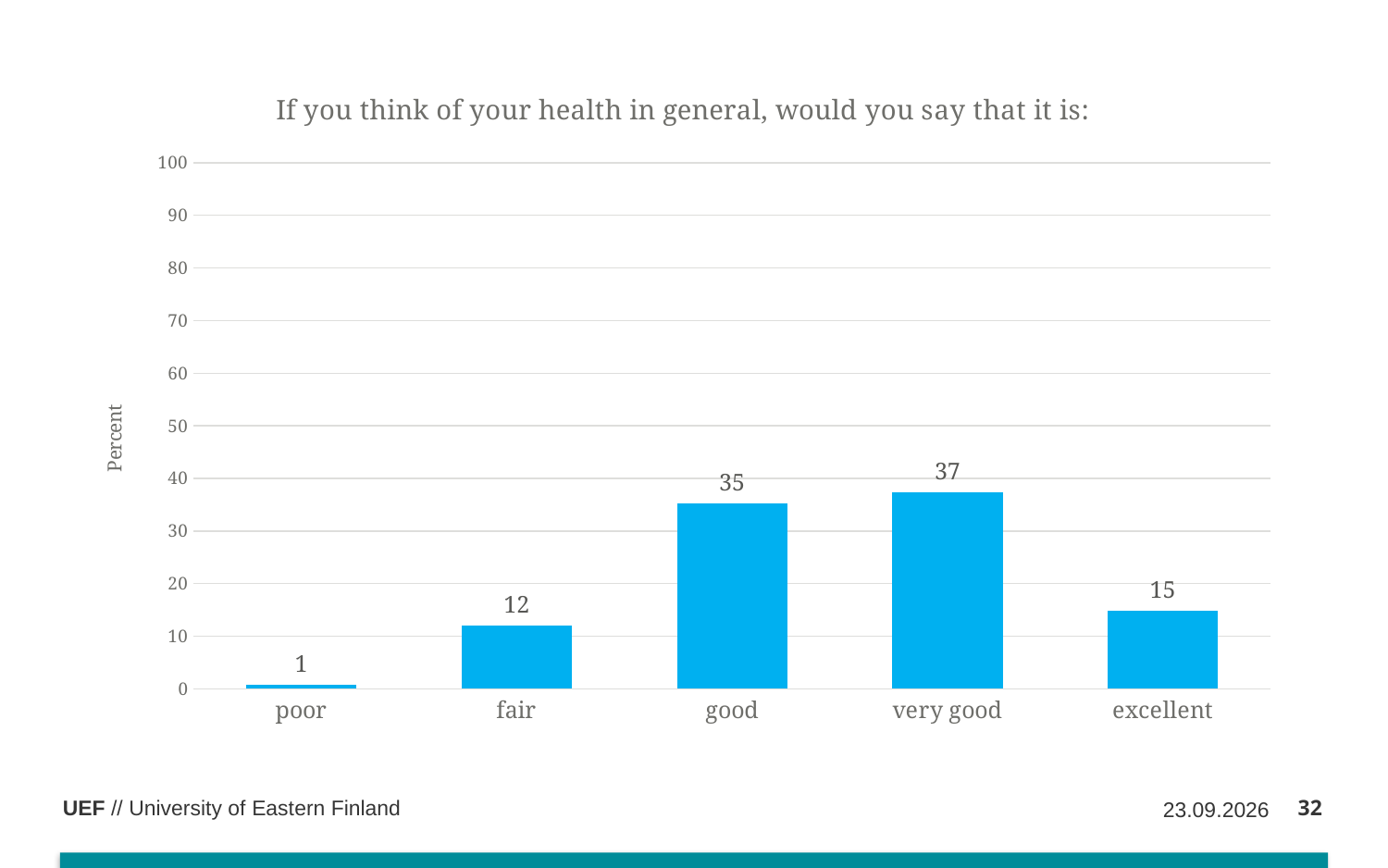
What is the value for "excellent"? 15 Which category has the highest value? very good Which category has the lowest value? poor Which is larger, the value for "fair" or the value for "excellent"? excellent What is the value for "poor"? 1 What kind of chart is shown on the slide? bar chart How many categories are shown on the x axis? 5 What is the label of the vertical axis? Percent Is the value for "good" greater or less than 30? greater What is the value for "good"? 35 What is the title of the chart? If you think of your health in general, would you say that it is: What is the difference between the values for "very good" and "fair"? 25